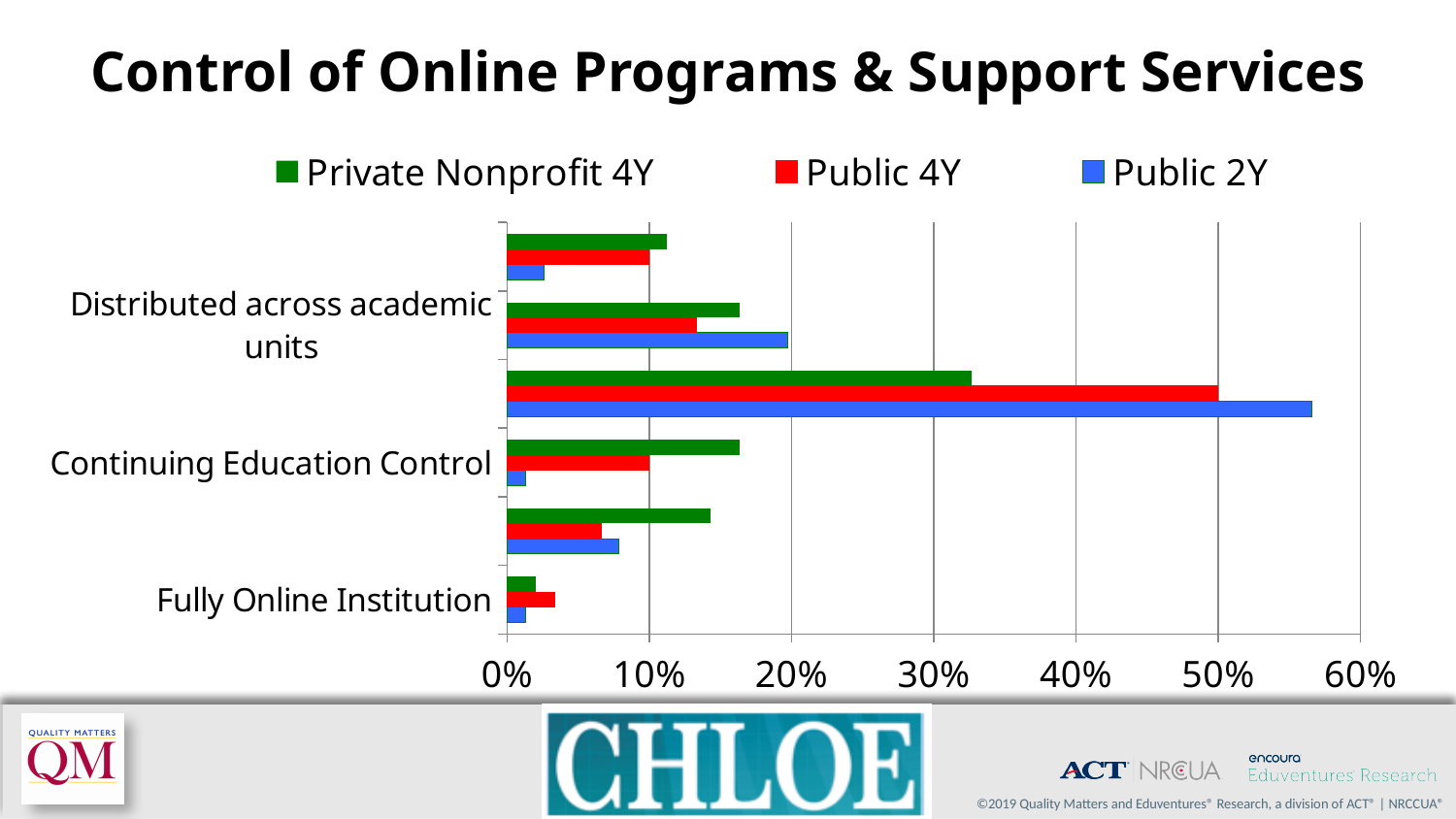
For Continuing Education Control, which is larger: Private Nonprofit 4Y or Public 2Y? Private Nonprofit 4Y How many series does the legend list? 3 Which series has the highest value for Distributed across academic units? Public 2Y For Distributed across academic units, which is larger: Public 2Y or Public 4Y? Public 2Y Is the Private Nonprofit 4Y value for Continuing Education Control greater or less than 10%? greater Is the Public 2Y value for Distributed across academic units greater or less than 10%? greater Is the Public 4Y value for Fully Online Institution greater or less than 10%? less What colour represents Public 2Y in the chart? blue What are the three series named in the legend? Private Nonprofit 4Y, Public 4Y, Public 2Y What kind of chart is shown on the slide? bar chart Which series has the lowest value for Continuing Education Control? Public 2Y